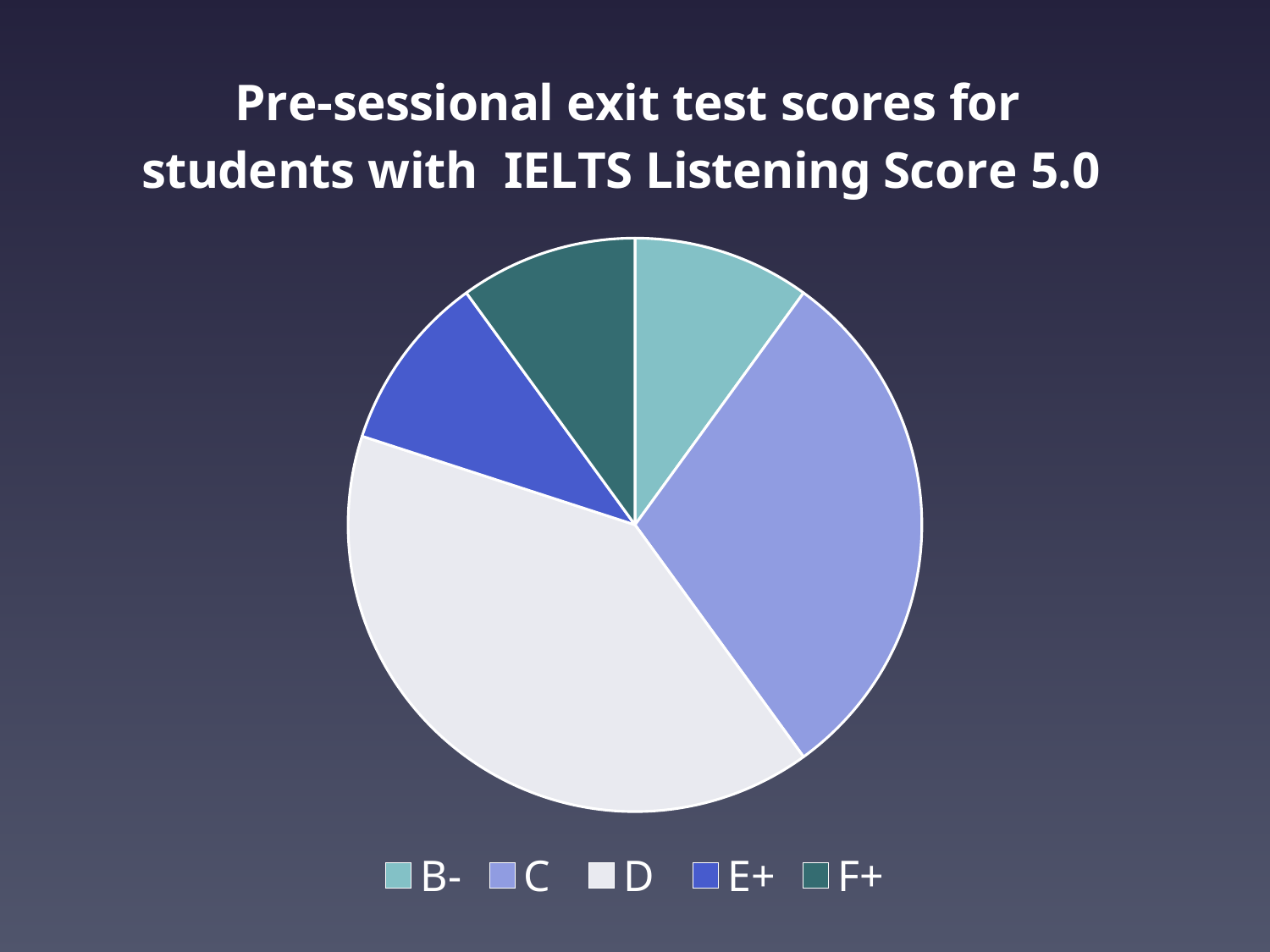
Which slice is larger, C or B-? C Which category has the largest slice of the pie? D What kind of chart is shown on the slide? pie chart Which slice is larger, C or F+? C What is the title of the chart? Pre-sessional exit test scores for students with IELTS Listening Score 5.0 How many categories does the pie chart show? 5 Which slice is larger, D or C? D Which categories are listed in the legend? B-, C, D, E+, F+